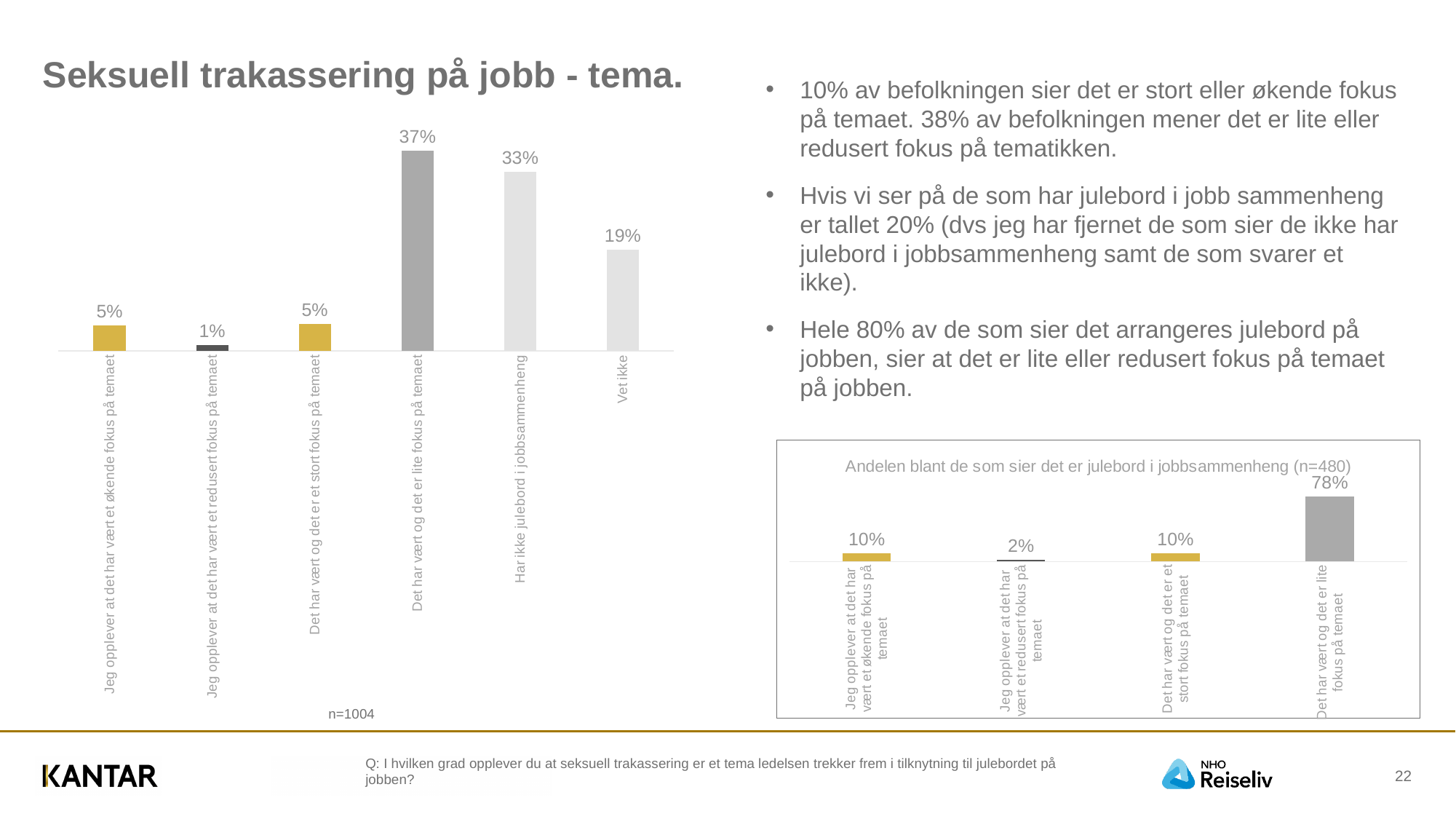
In the left chart (n=1004), what is the value for "Har ikke julebord i jobbsammenheng"? 33% In the left chart (n=1004), which category has the highest value? Det har vært og det er lite fokus på temaet In the left chart (n=1004), what is the difference between "Det har vært og det er lite fokus på temaet" and "Har ikke julebord i jobbsammenheng"? 4% In the chart titled "Andelen blant de som sier det er julebord i jobbsammenheng (n=480)", what is the value for "Jeg opplever at det har vært et redusert fokus på temaet"? 2% How many categories are shown in the left chart (n=1004)? 6 In the left chart (n=1004), what is the value for "Vet ikke"? 19% How many categories are shown in the chart titled "Andelen blant de som sier det er julebord i jobbsammenheng (n=480)"? 4 In the left chart (n=1004), which category has the lowest value? Jeg opplever at det har vært et redusert fokus på temaet In the chart titled "Andelen blant de som sier det er julebord i jobbsammenheng (n=480)", what is the value for "Det har vært og det er lite fokus på temaet"? 78% In the chart titled "Andelen blant de som sier det er julebord i jobbsammenheng (n=480)", which is larger: "Jeg opplever at det har vært et økende fokus på temaet" or "Jeg opplever at det har vært et redusert fokus på temaet"? Jeg opplever at det har vært et økende fokus på temaet What type of chart is the left chart (n=1004)? Bar chart In the left chart (n=1004), what is the value for "Det har vært og det er lite fokus på temaet"? 37%